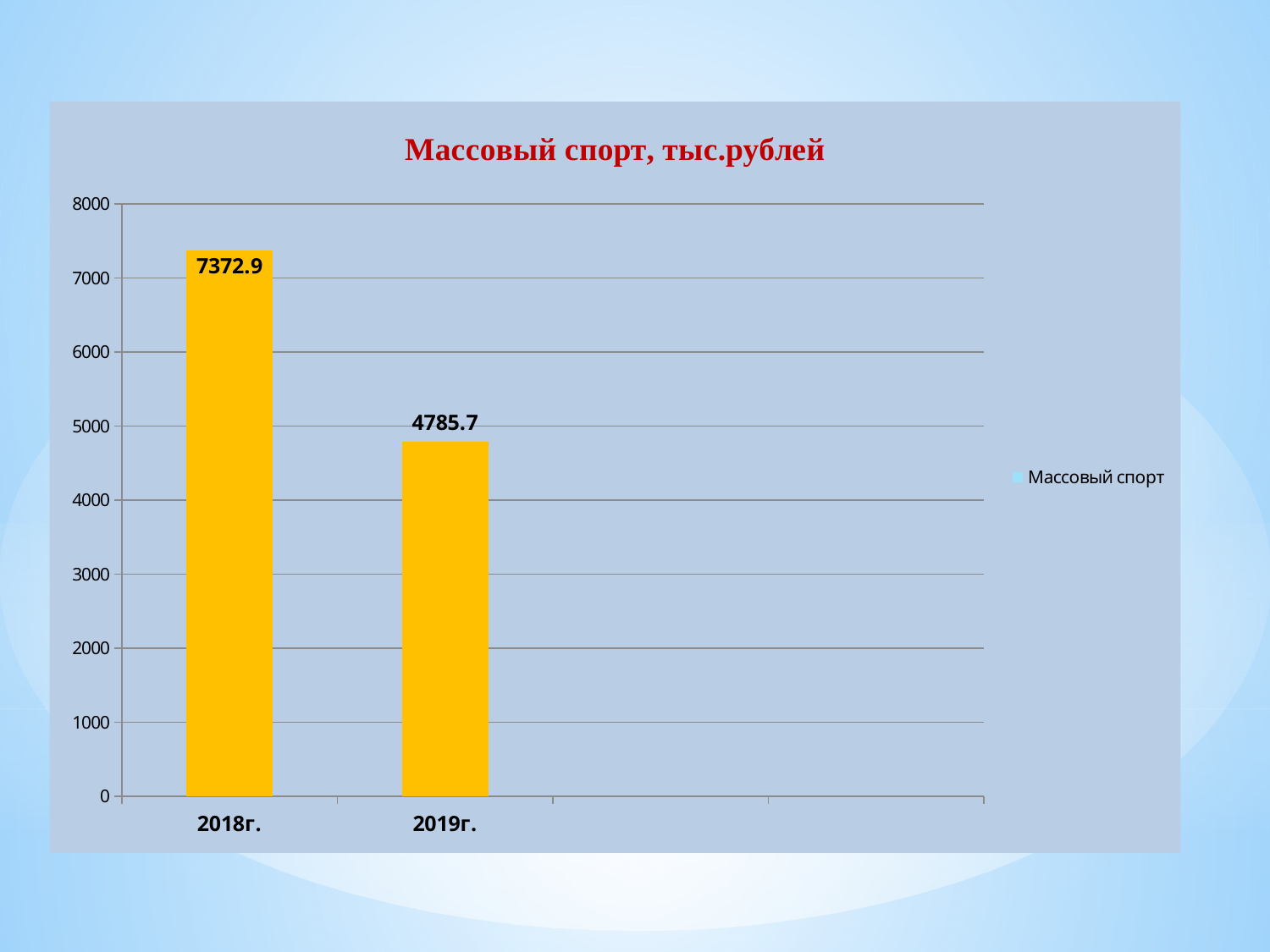
Is the value for 2018г. greater or less than 7000? greater What kind of chart is shown? bar chart How many categories are shown on the x axis? 2 Which year has the lowest value? 2019г. What is the value for 2019г.? 4785.7 Which is larger, the value for 2018г. or the value for 2019г.? 2018г. Which year has the highest value? 2018г. What is the difference between the values for 2018г. and 2019г.? 2587.2 Do the values rise or fall from 2018г. to 2019г.? fall What is the value for 2018г.? 7372.9 How many series does the legend list? 1 Is the value for 2019г. greater or less than 5000? less